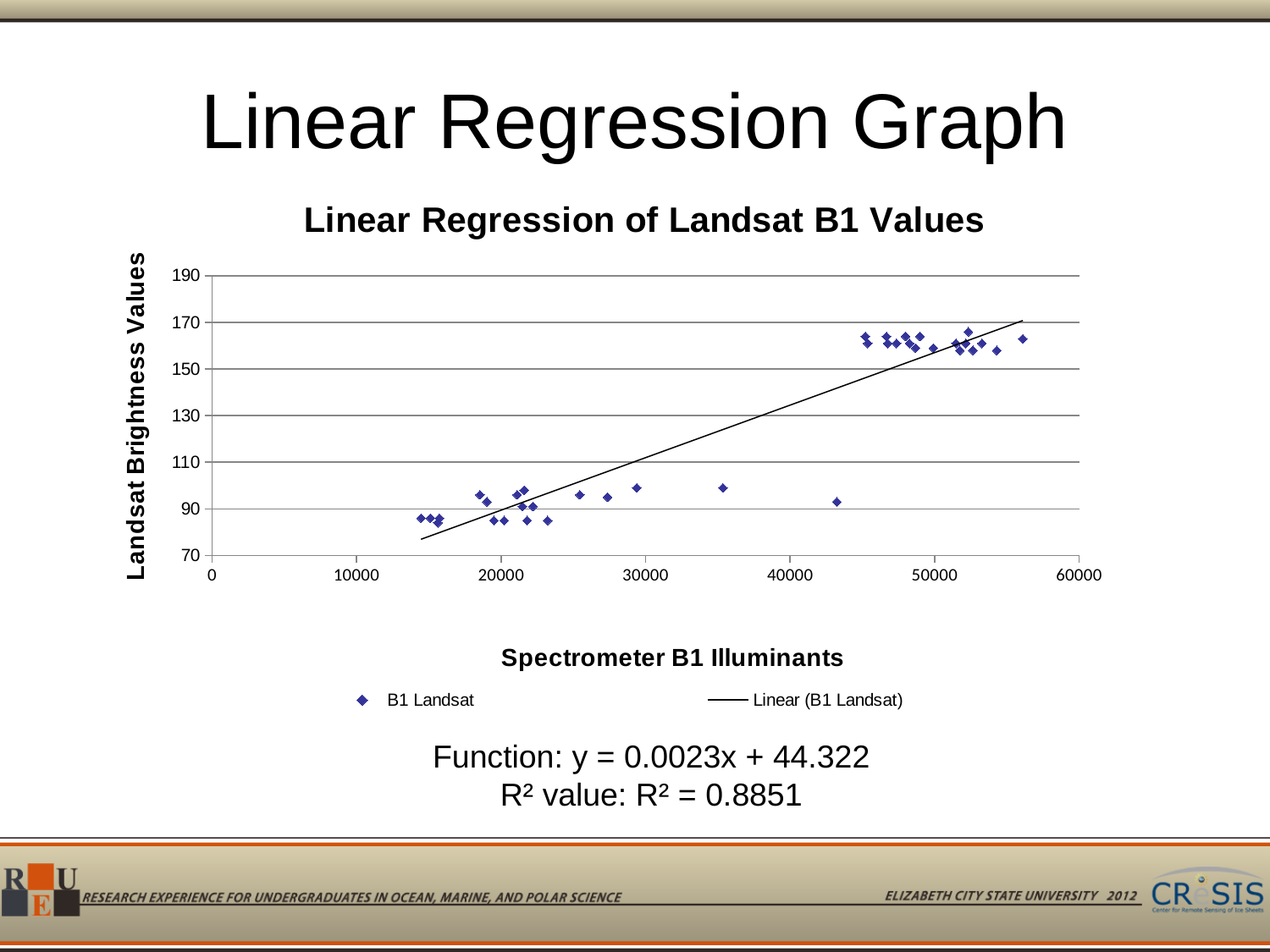
Is the value of the fitted line at 20000 on the x axis greater or less than 110? less How many entries does the chart legend list? 2 What is the title of the chart? Linear Regression of Landsat B1 Values Do the Landsat brightness values generally rise or fall as the Spectrometer B1 Illuminants increase along the x axis? rise Is the Landsat brightness value for the point at roughly 43000 on the x axis greater or less than 110? less Is the Landsat brightness value for the point at roughly 35000 on the x axis greater or less than 110? less What kind of chart is shown on the slide? scatter plot What is the label of the vertical axis? Landsat Brightness Values Which group of points has higher Landsat brightness values: those near 20000 or those near 50000 on the x axis? those near 50000